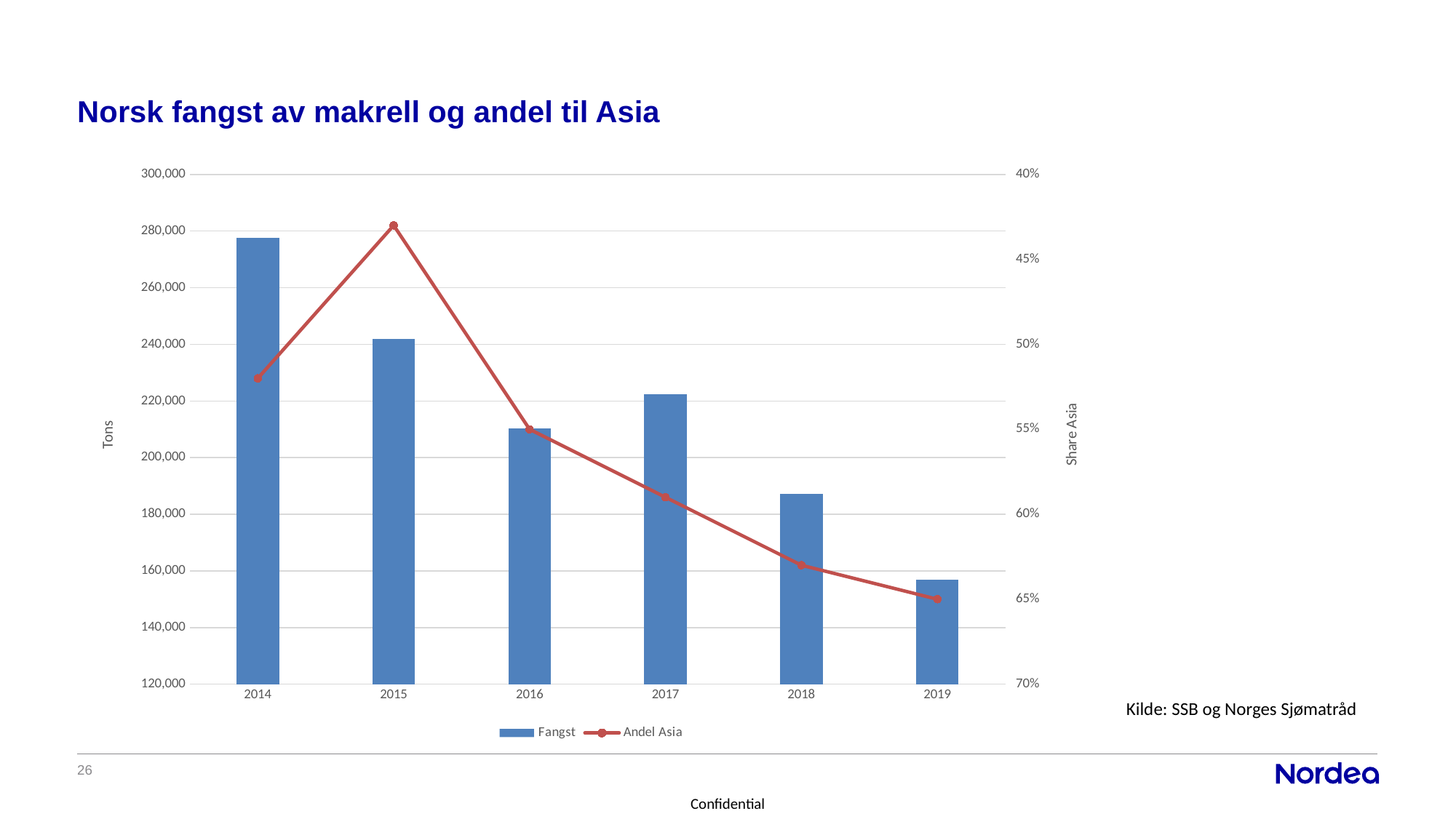
Do the Fangst bars generally rise or fall from 2014 to 2019? fall Is the Andel Asia value for 2015 greater or less than 50%? less Which year has the larger Fangst bar, 2016 or 2017? 2017 Which year has the highest Fangst (catch) bar? 2014 Which year has the lowest Fangst (catch) bar? 2019 What kind of chart is shown on the slide? A combination bar and line chart How many years are shown on the x axis of the chart? 6 Is the Fangst value for 2019 greater or less than 180,000 tons? less What is the label of the left vertical axis? Tons Is the Fangst value for 2018 greater or less than 200,000 tons? less How many series does the legend list? 2